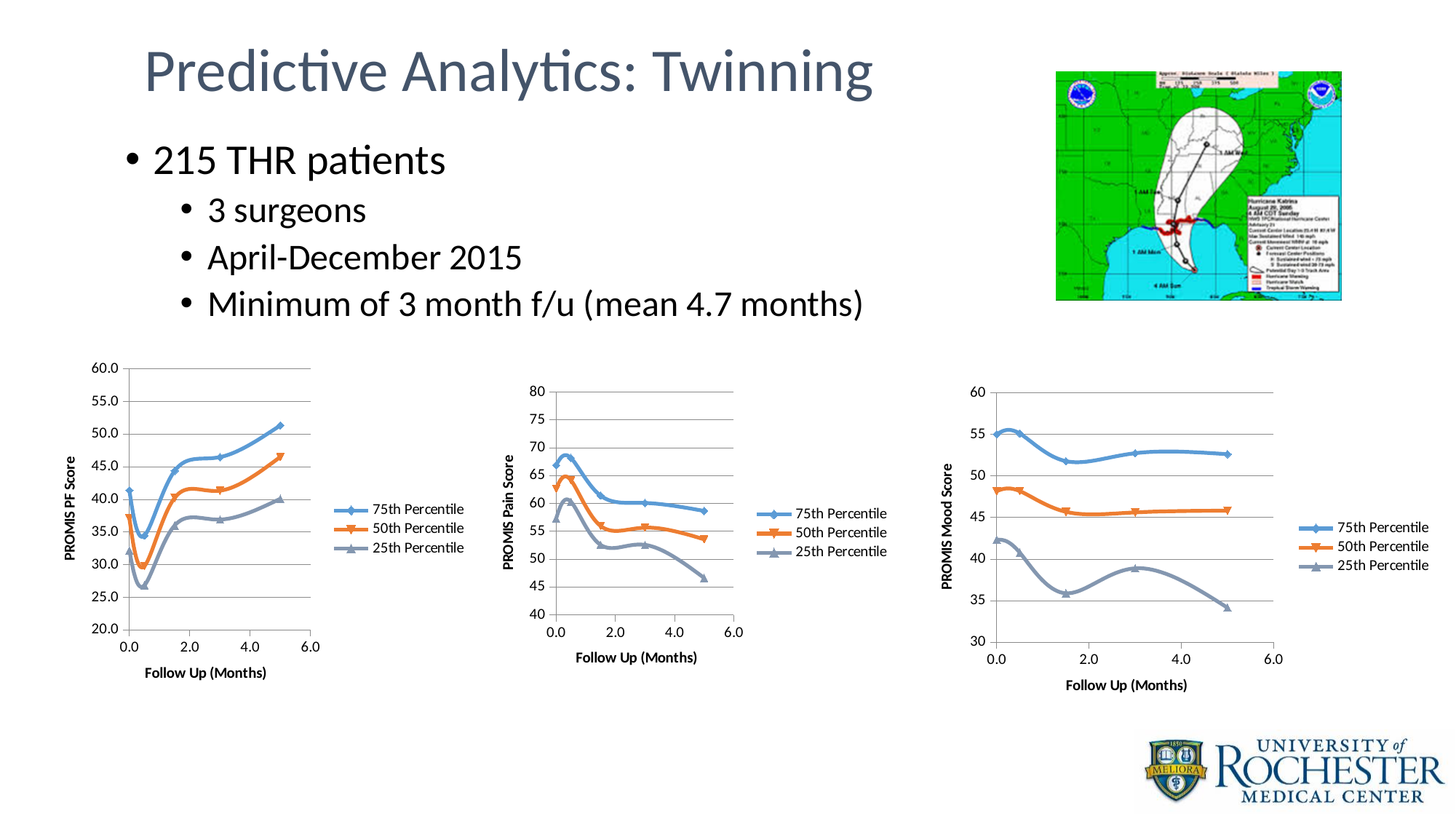
In the rightmost chart (PROMIS Mood Score), which series has the larger value at 5.0 months, 75th Percentile or 25th Percentile? 75th Percentile What kind of chart is the leftmost chart (PROMIS PF Score)? line chart In the leftmost chart (PROMIS PF Score), is the 25th Percentile value at 0.5 months greater or less than 30.0? less In the middle chart (PROMIS Pain Score), is the 25th Percentile value at 5.0 months greater or less than 50? less In the leftmost chart (PROMIS PF Score), does the 75th Percentile line rise or fall between 1.5 and 5.0 months? rise In the leftmost chart (PROMIS PF Score), is the 75th Percentile value at 5.0 months greater or less than 50.0? greater How many series does the legend of the middle chart (PROMIS Pain Score) list? 3 In the rightmost chart (PROMIS Mood Score), what are the three legend entries? 75th Percentile, 50th Percentile, 25th Percentile In the middle chart (PROMIS Pain Score), does the 25th Percentile line rise or fall between 3.0 and 5.0 months? fall What is the x-axis label of the leftmost chart (PROMIS PF Score)? Follow Up (Months)